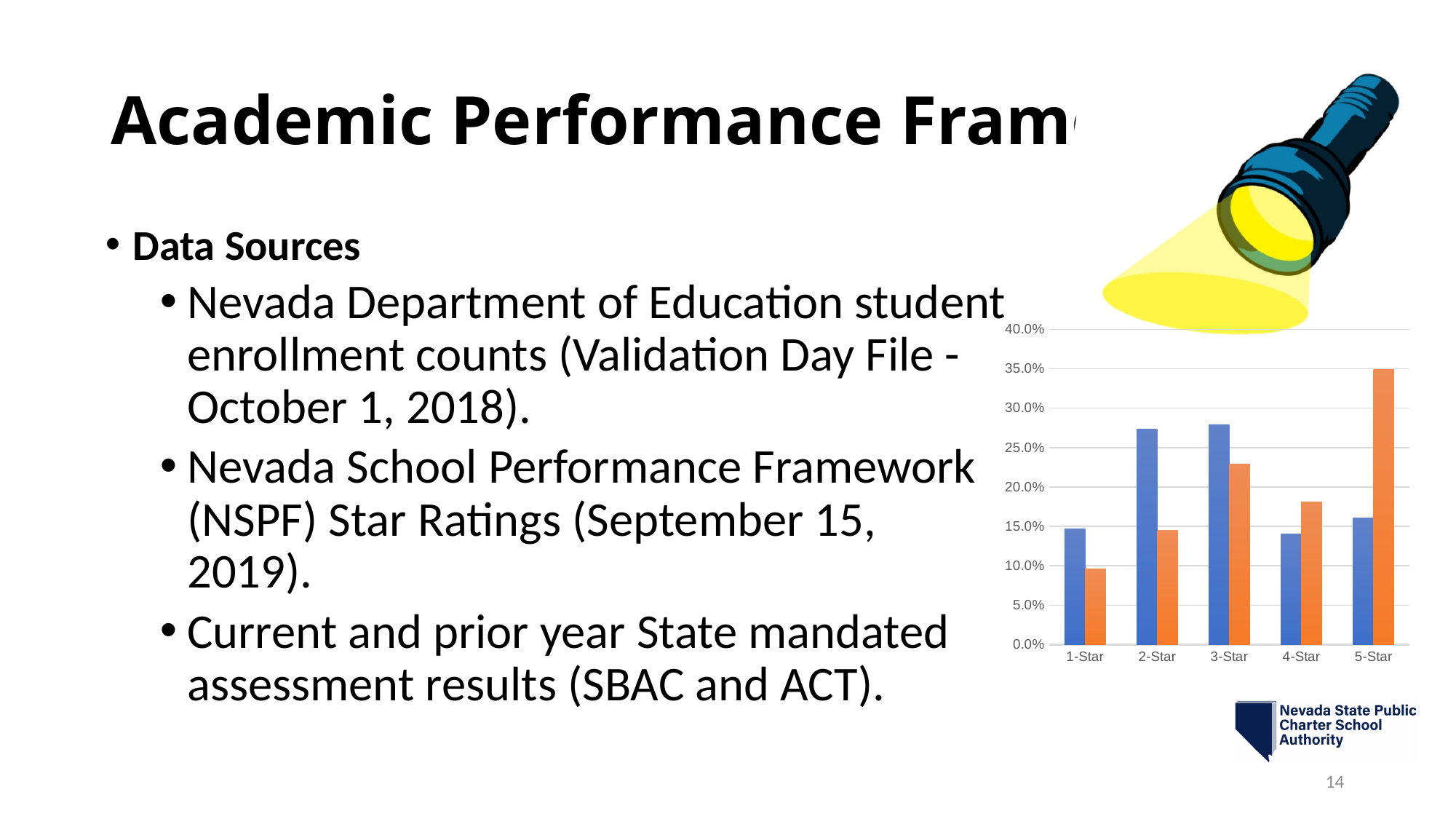
Is the blue bar for 2-Star greater or less than 25.0%? greater For 2-Star, which bar is taller, the blue one or the orange one? blue What kind of chart is shown on the right side of the slide? bar chart How many data series (bar colours) are plotted in the chart? 2 Is the orange bar for 3-Star greater or less than 20.0%? greater Is the orange bar for 5-Star greater or less than 30.0%? greater How many categories are shown on the x axis of the chart? 5 Which category has the highest orange bar in the chart? 5-Star What is the highest value shown on the chart's vertical axis? 40.0% Which category has the lowest orange bar in the chart? 1-Star For 5-Star, which bar is taller, the blue one or the orange one? orange